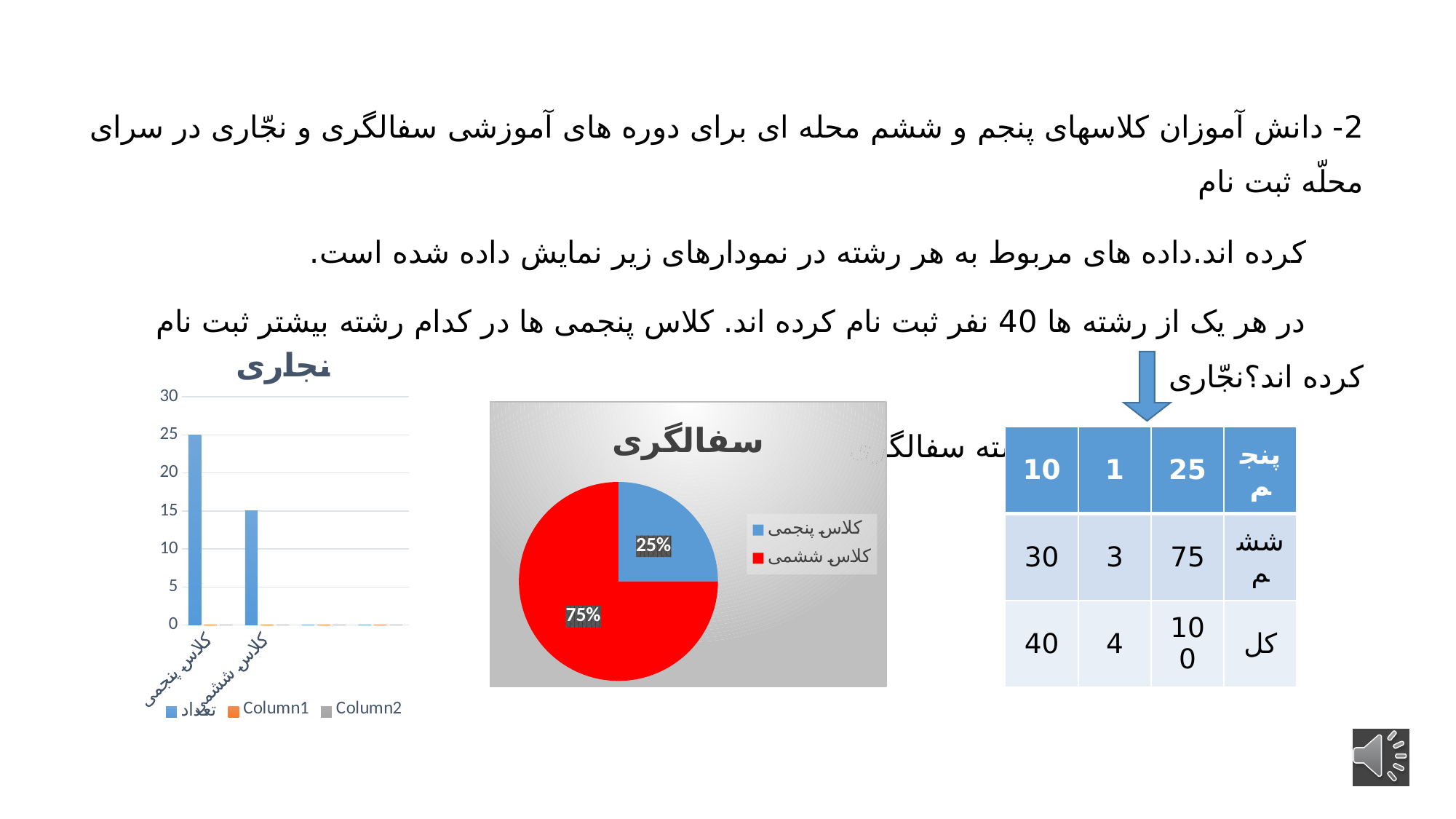
In the bar chart titled نجاری, which category has the lowest value? کلاس ششمی In the pie chart titled سفالگری, which slice is larger, کلاس پنجمی or کلاس ششمی? کلاس ششمی In the pie chart titled سفالگری, what share does کلاس پنجمی have? 25% In the bar chart titled نجاری, what is the value for کلاس پنجمی? 25 In the pie chart titled سفالگری, what colour is the slice for کلاس ششمی? red In the bar chart titled نجاری, what is the difference between the values for کلاس پنجمی and کلاس ششمی? 10 In the bar chart titled نجاری, how many series does the legend list? 3 In the pie chart titled سفالگری, what share does کلاس ششمی have? 75% In the bar chart titled نجاری, what is the value for کلاس ششمی? 15 In the bar chart titled نجاری, is the value for کلاس پنجمی greater or less than 20? greater In the bar chart titled نجاری, which category has the highest value? کلاس پنجمی What kind of chart is the chart titled نجاری? bar chart